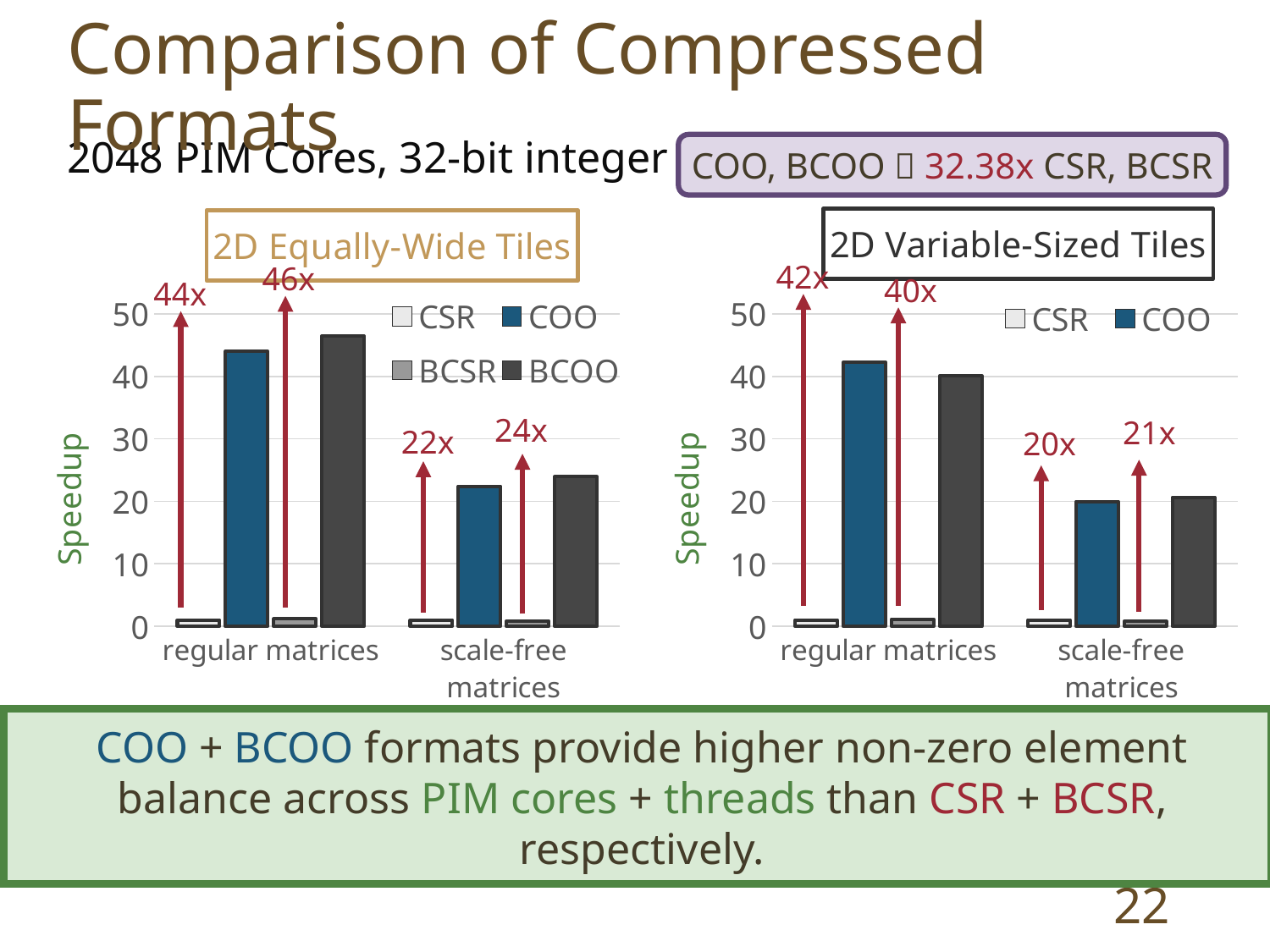
What kind of chart is the "2D Equally-Wide Tiles" chart? bar chart How many series does the legend of the "2D Equally-Wide Tiles" chart list? 4 In the "2D Equally-Wide Tiles" chart, is the COO value for regular matrices greater or less than 40? greater In the "2D Variable-Sized Tiles" chart, is the COO value for regular matrices greater or less than 30? greater What is the y-axis label of the "2D Equally-Wide Tiles" chart? Speedup In the "2D Variable-Sized Tiles" chart, is the BCOO value for scale-free matrices greater or less than 30? less In the "2D Variable-Sized Tiles" chart, do the BCOO values rise or fall from regular matrices to scale-free matrices? fall In the "2D Variable-Sized Tiles" chart, which bar is the highest? COO for regular matrices In the "2D Equally-Wide Tiles" chart, which bar is the highest? BCOO for regular matrices How many categories are shown on the x axis of the "2D Variable-Sized Tiles" chart? 2 In the "2D Equally-Wide Tiles" chart, which is larger: the COO value for regular matrices or the COO value for scale-free matrices? regular matrices